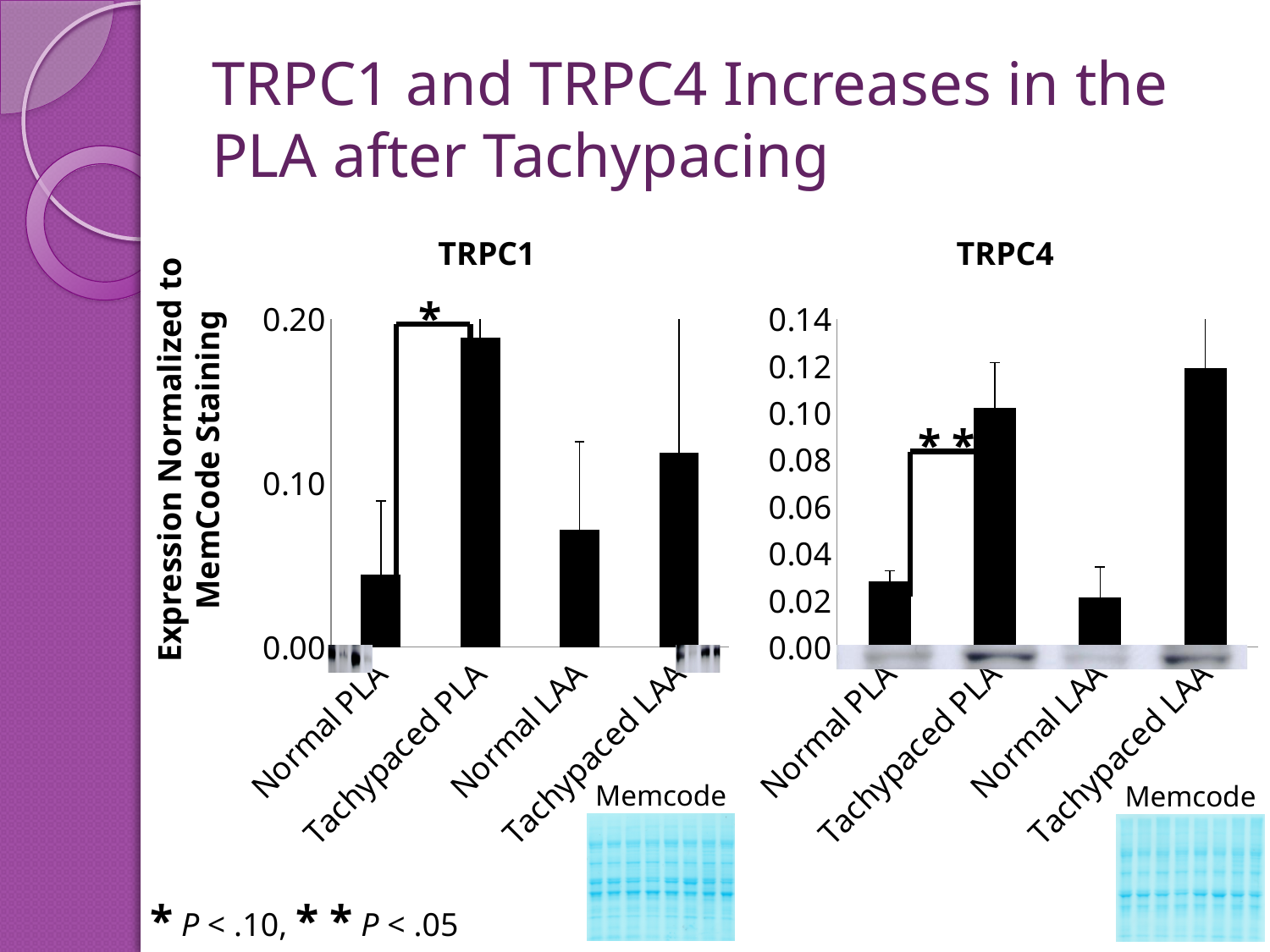
How many categories are shown on the x axis of the TRPC4 chart? 4 What type of chart is the TRPC1 chart? bar chart In the TRPC4 chart, which category has the highest value? Tachypaced LAA In the TRPC1 chart, which category has the lowest value? Normal PLA In the TRPC1 chart, is the value for Normal PLA greater or less than 0.10? less In the TRPC4 chart, is the value for Normal LAA greater or less than 0.04? less In the TRPC1 chart, is the value for Tachypaced PLA greater or less than 0.10? greater In the TRPC1 chart, which is larger, the value for Normal LAA or Tachypaced LAA? Tachypaced LAA In the TRPC4 chart, which is larger, the value for Tachypaced PLA or Tachypaced LAA? Tachypaced LAA In the TRPC1 chart, which category has the highest value? Tachypaced PLA What is the y-axis label shared by the two charts? Expression Normalized to MemCode Staining